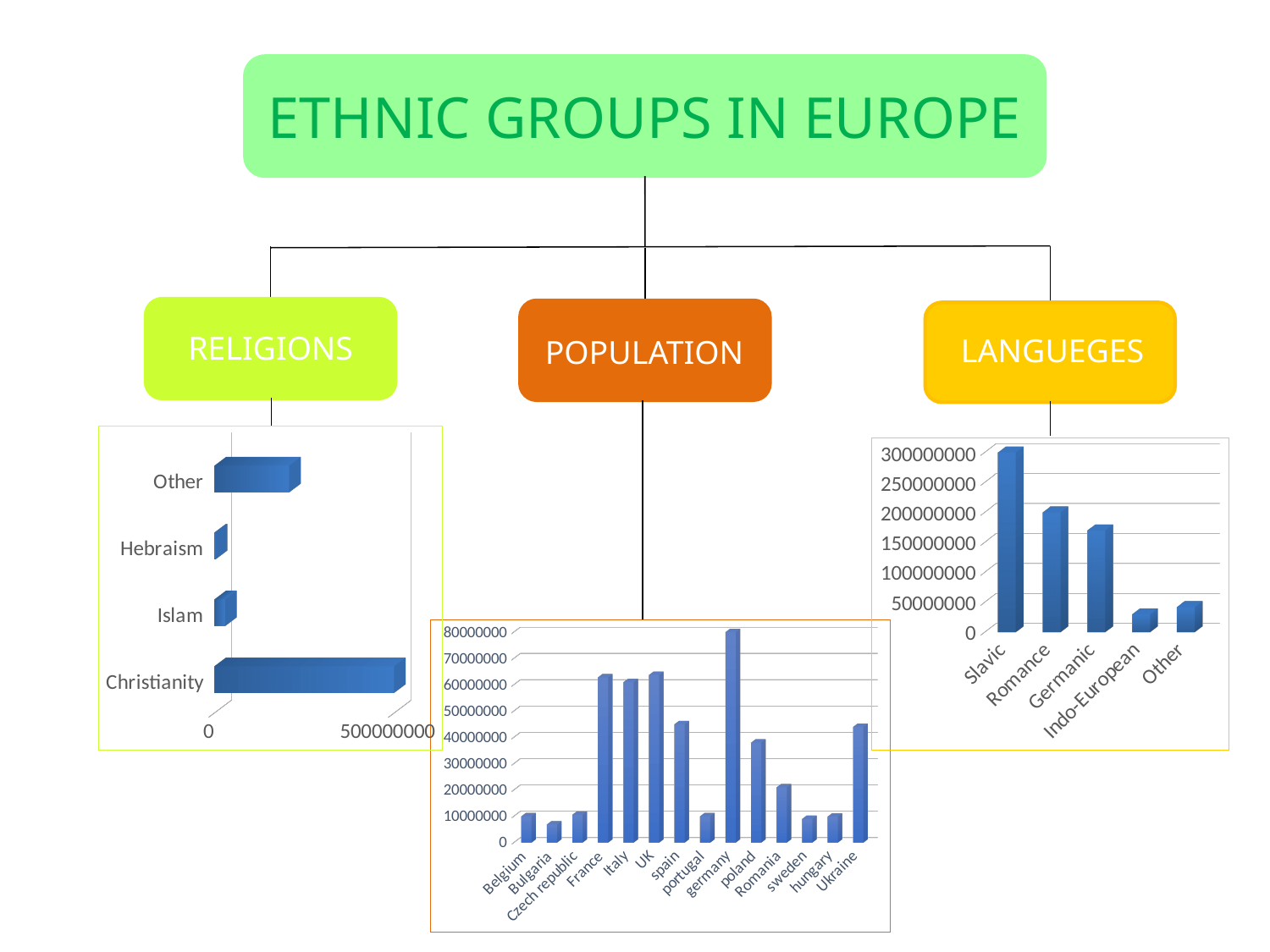
In the Population chart, is the value for Italy greater or less than 50000000? greater In the Population chart, is the value for Romania greater or less than 30000000? less In the Religions chart, which category has the highest value? Christianity In the Population chart, which country has the highest value? germany In the Population chart, which is larger, France or spain? France How many countries are shown in the Population chart? 14 How many categories are shown in the Languages chart? 5 In the Languages chart, which is larger, Romance or Germanic? Romance In the Religions chart, which category has the lowest value? Hebraism What type of chart is the Population chart? bar chart In the Languages chart, is the value for Romance greater or less than 150000000? greater In the Languages chart, which category has the highest value? Slavic